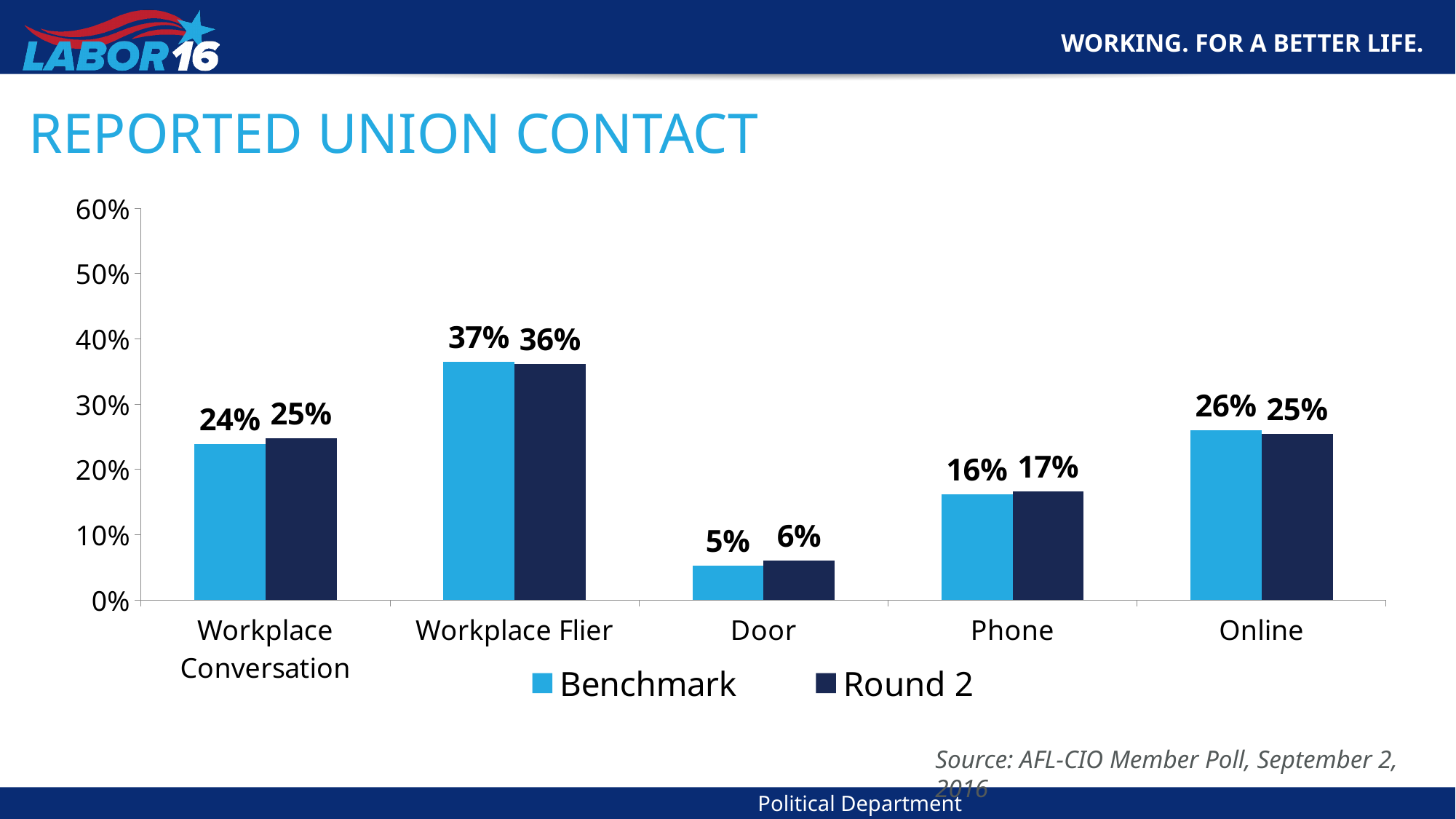
What is the Round 2 value for Door? 6% What is the Benchmark value for Workplace Flier? 37% What is the Round 2 value for Online? 25% What is the Benchmark value for Phone? 16% Which category has the highest Benchmark value? Workplace Flier Which is larger for Online: the Benchmark value or the Round 2 value? Benchmark What is the title of the chart? REPORTED UNION CONTACT What is the difference between the Benchmark and Round 2 values for Workplace Conversation? 1% Which category has the lowest Round 2 value? Door How many categories are shown on the x axis? 5 What kind of chart is shown on the slide? Bar chart How many series does the legend list? 2